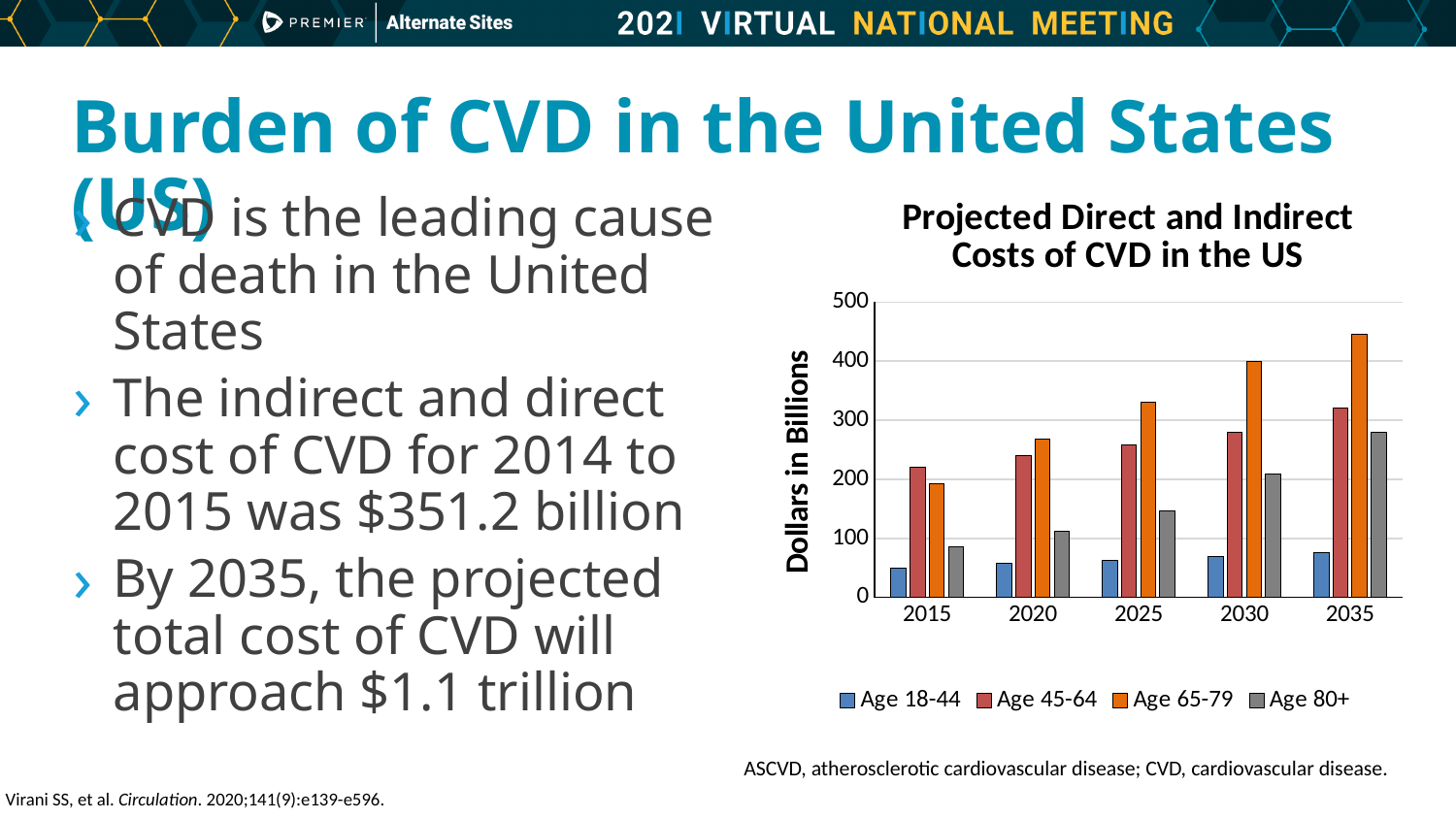
What is the label on the y axis of the chart? Dollars in Billions Is the value for Age 65-79 in 2035 greater or less than 400? greater How many years are shown on the x axis of the chart? 5 What kind of chart is shown on the slide? bar chart How many series does the chart legend list? 4 Is the value for Age 18-44 in 2015 greater or less than 100? less Which age group has the highest projected cost in 2035? Age 65-79 Which age group has the lowest projected cost in 2015? Age 18-44 In 2030, which is larger: the value for Age 45-64 or the value for Age 80+? Age 45-64 Is the value for Age 80+ in 2035 greater or less than 200? greater What is the title of the chart? Projected Direct and Indirect Costs of CVD in the US Do the values for Age 65-79 rise or fall from 2015 to 2035? rise